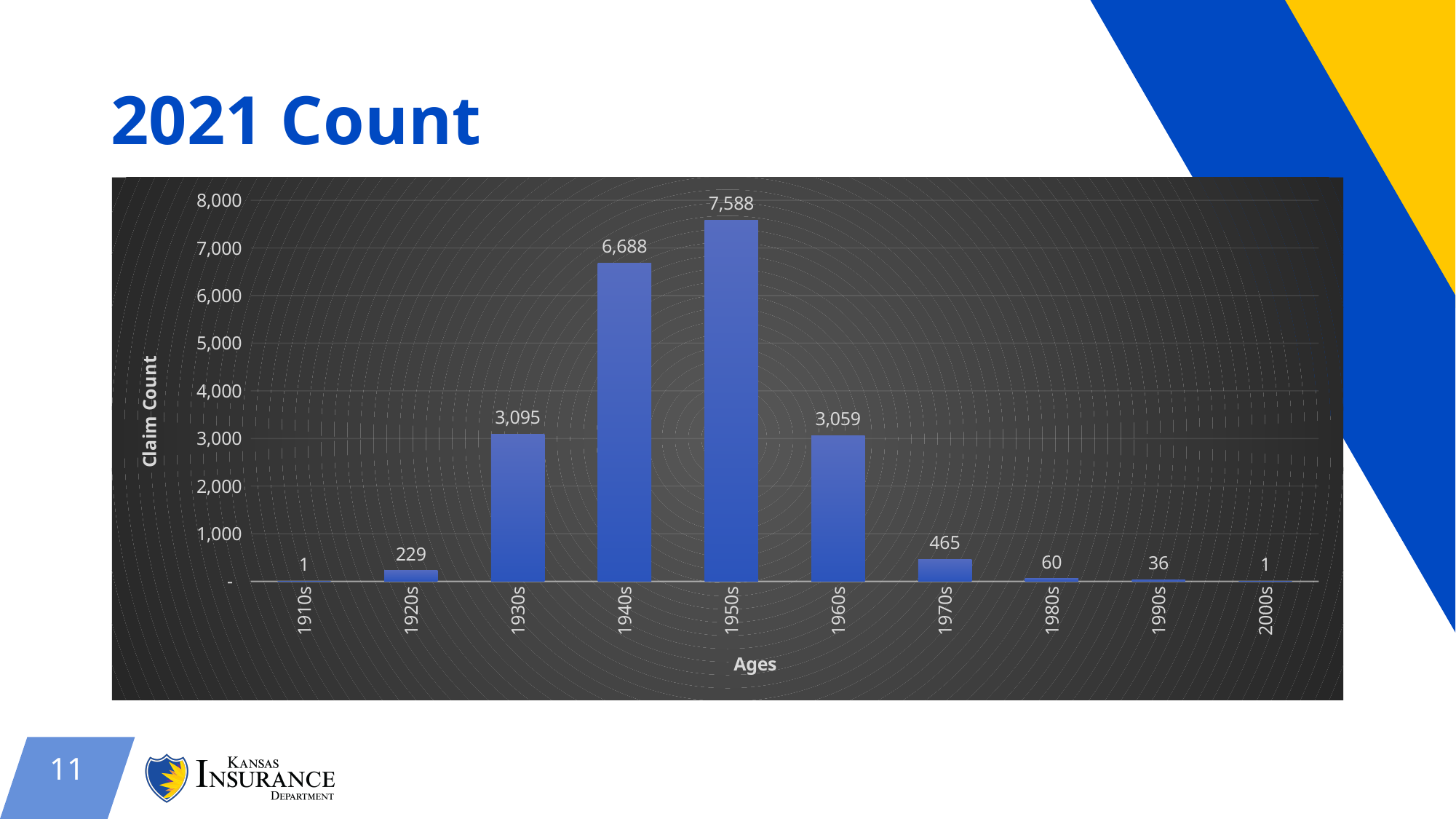
What is the difference in claim count between the 1930s and 1960s age groups? 36 How many age groups are shown on the x axis? 10 What is the label of the vertical axis? Claim Count Which age group has a larger claim count, the 1930s or the 1960s? 1930s Is the claim count for the 1940s greater or less than 6,000? greater What is the claim count for the 1950s age group? 7,588 What type of chart is shown on the slide? Bar chart What is the claim count for the 1940s age group? 6,688 What is the claim count for the 1970s age group? 465 Which age group has the highest claim count? 1950s What is the claim count for the 1920s age group? 229 What is the difference in claim count between the 1950s and 1940s age groups? 900